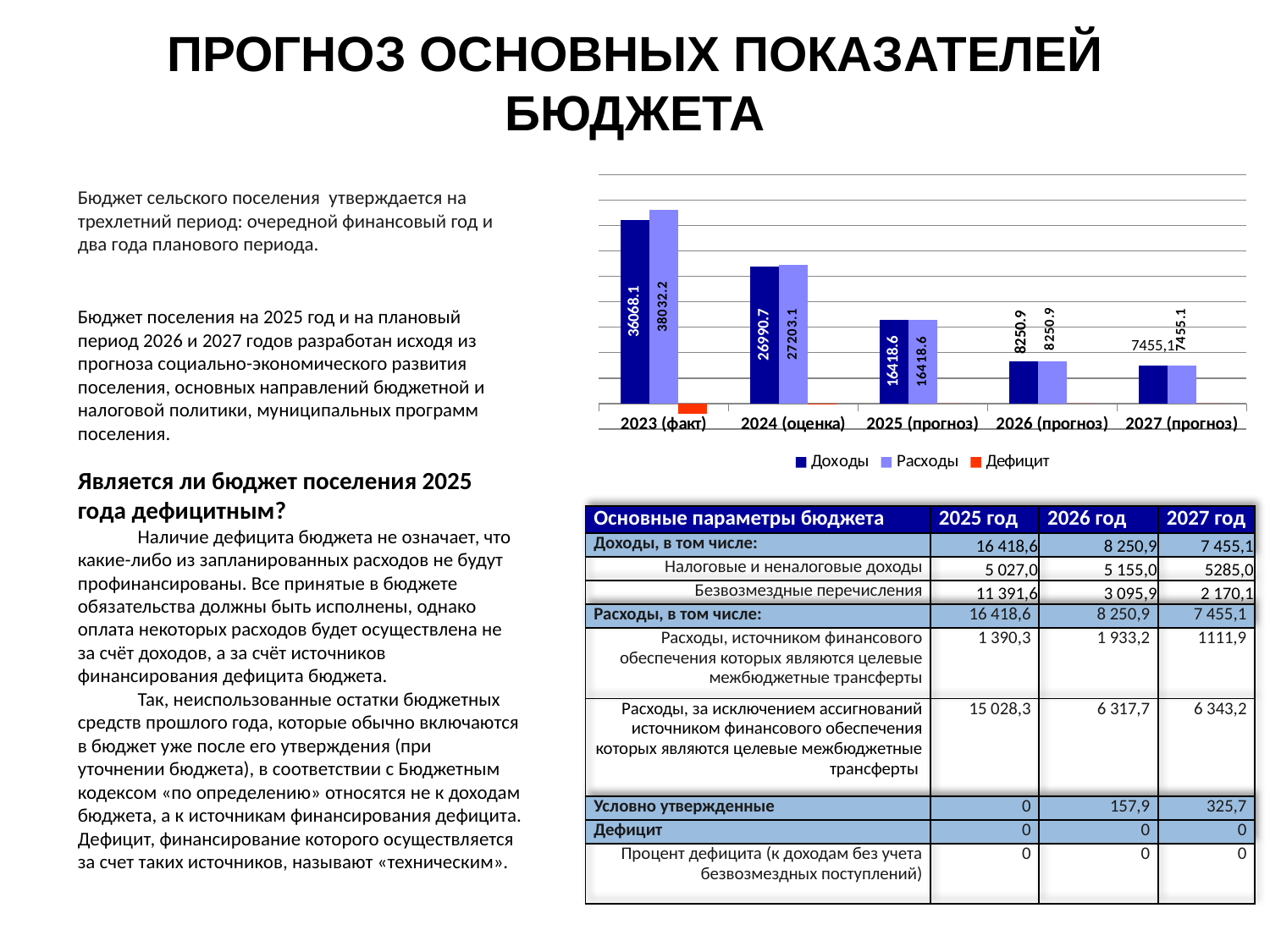
What is the value of Доходы for 2024 (оценка)? 26990.7 How many year categories are shown on the x axis of the chart? 5 What is the value of Расходы for 2025 (прогноз)? 16418.6 Which year has the lowest Расходы value? 2027 (прогноз) What is the difference between Расходы and Доходы in 2023 (факт)? 1964.1 What is the value of Доходы for 2027 (прогноз)? 7455.1 What is the value of Доходы for 2023 (факт)? 36068.1 What is the value of Расходы for 2023 (факт)? 38032.2 How many series does the chart legend list? 3 Which year has the highest Доходы value? 2023 (факт) What kind of chart is shown on the slide? bar chart Do the Доходы values rise or fall from 2023 to 2027 along the x axis? fall